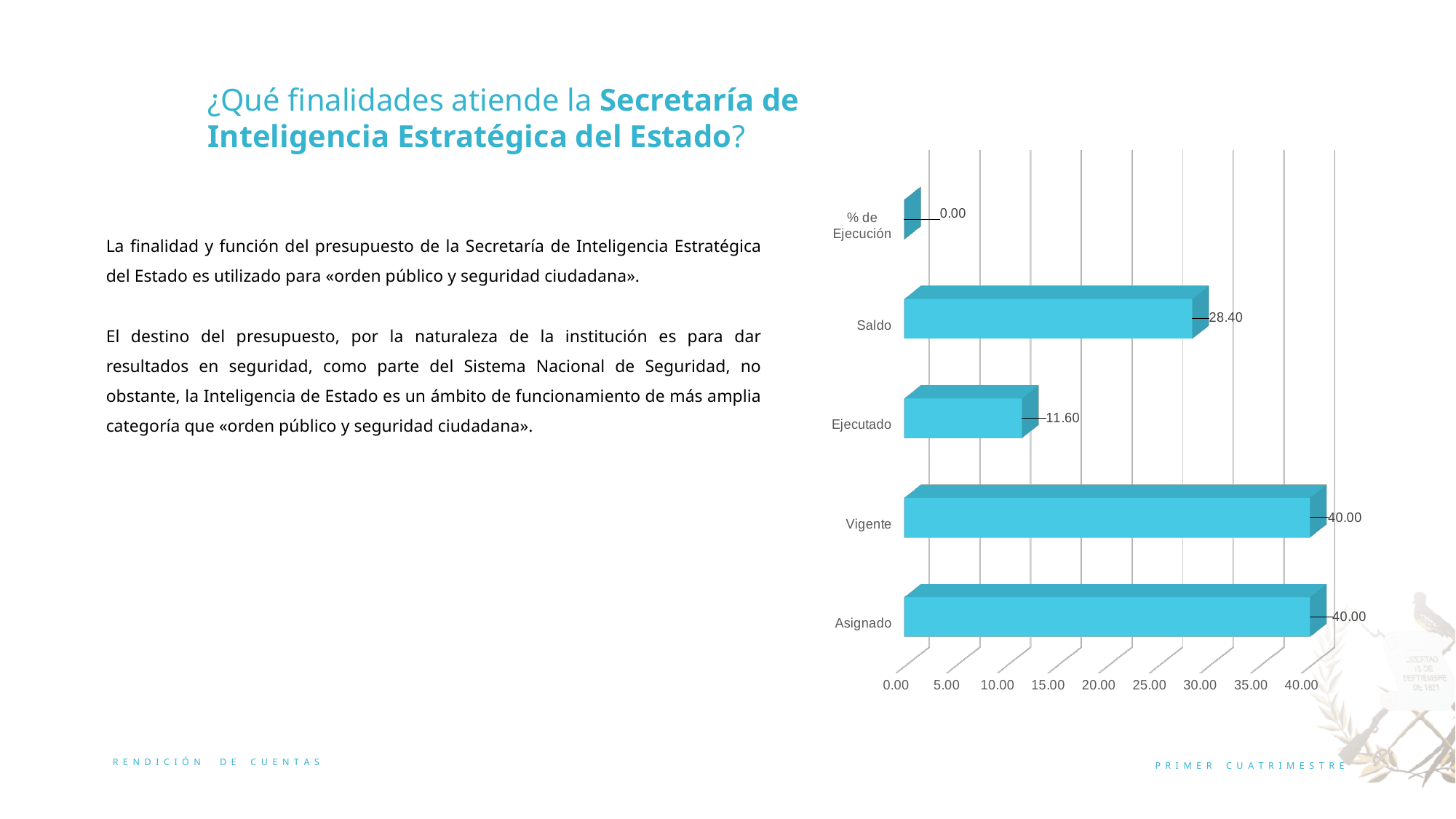
What is the difference between the values for Asignado and Saldo? 11.60 What is the value for % de Ejecución? 0.00 How many categories are shown in the chart? 5 Is the value for Saldo greater or less than 25.00? greater What is the value for Saldo? 28.40 Which is larger, the value for Saldo or the value for Ejecutado? Saldo What is the value for Vigente? 40.00 Which category has the lowest value? % de Ejecución What is the value for Ejecutado? 11.60 What is the difference between the values for Saldo and Ejecutado? 16.80 What kind of chart is shown on the slide? bar chart What is the highest value shown on the horizontal axis? 40.00